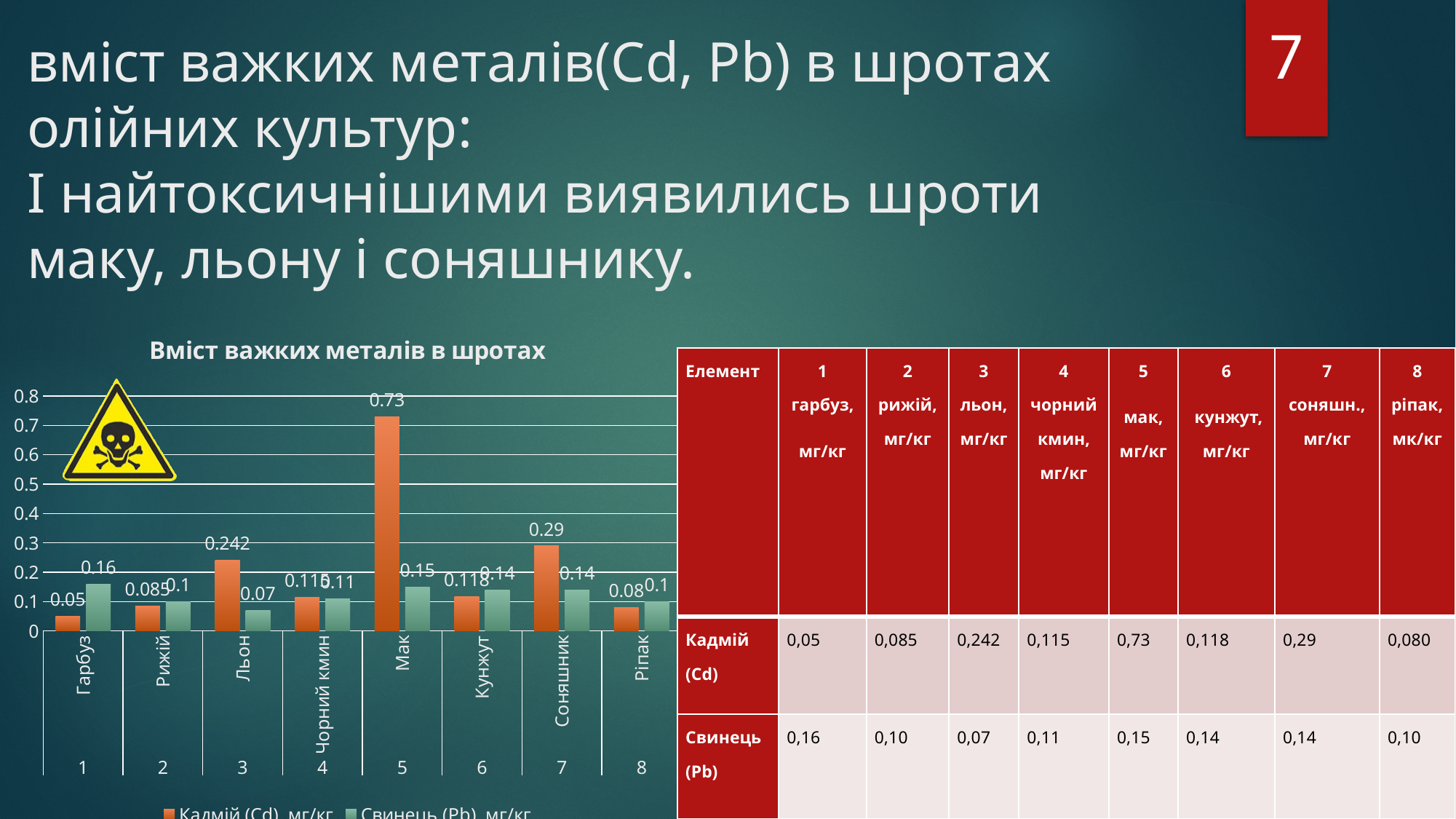
What is the cadmium (Cd) value for Льон on the chart? 0.242 What is the cadmium (Cd) value for Мак on the chart? 0.73 What is the title of the chart? Вміст важких металів в шротах What is the difference between the cadmium (Cd) values for Мак and Соняшник? 0.44 Which crop has the highest cadmium (Cd) value on the chart? Мак How many categories (crops) are plotted on the chart? 8 How many series does the chart legend list? 2 Is the cadmium (Cd) value for Мак greater or less than 0.5? greater What is the lead (Pb) value for Гарбуз on the chart? 0.16 What type of chart is shown on the slide? Bar chart Which crop has the lowest lead (Pb) value on the chart? Льон Which is larger for Рижій: the cadmium (Cd) value or the lead (Pb) value? Lead (Pb), 0.1